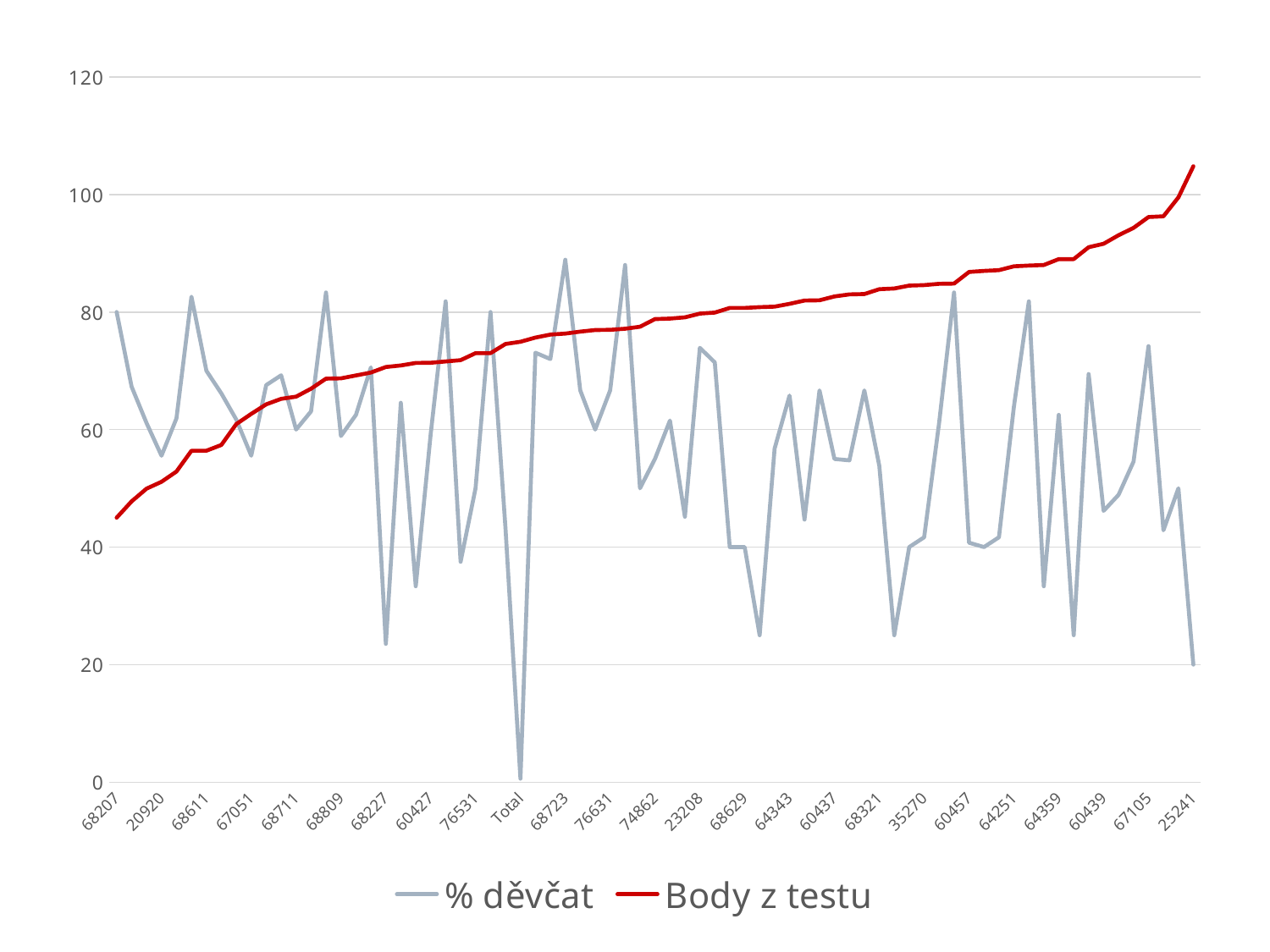
Is the Body z testu value for 25241 greater or less than 100? greater Which category has the lowest value for Body z testu? 68207 At category 25241, which series has the larger value, % děvčat or Body z testu? Body z testu Is the Body z testu value for 67105 greater or less than 80? greater Is the Body z testu value for 68207 greater or less than 60? less What are the two series named in the legend? % děvčat and Body z testu What kind of chart is shown on the slide? line chart Which colour is used for the Body z testu series? red Which category has the highest value for Body z testu? 25241 Does the Body z testu series rise or fall along the x axis? rise How many series does the legend list? 2